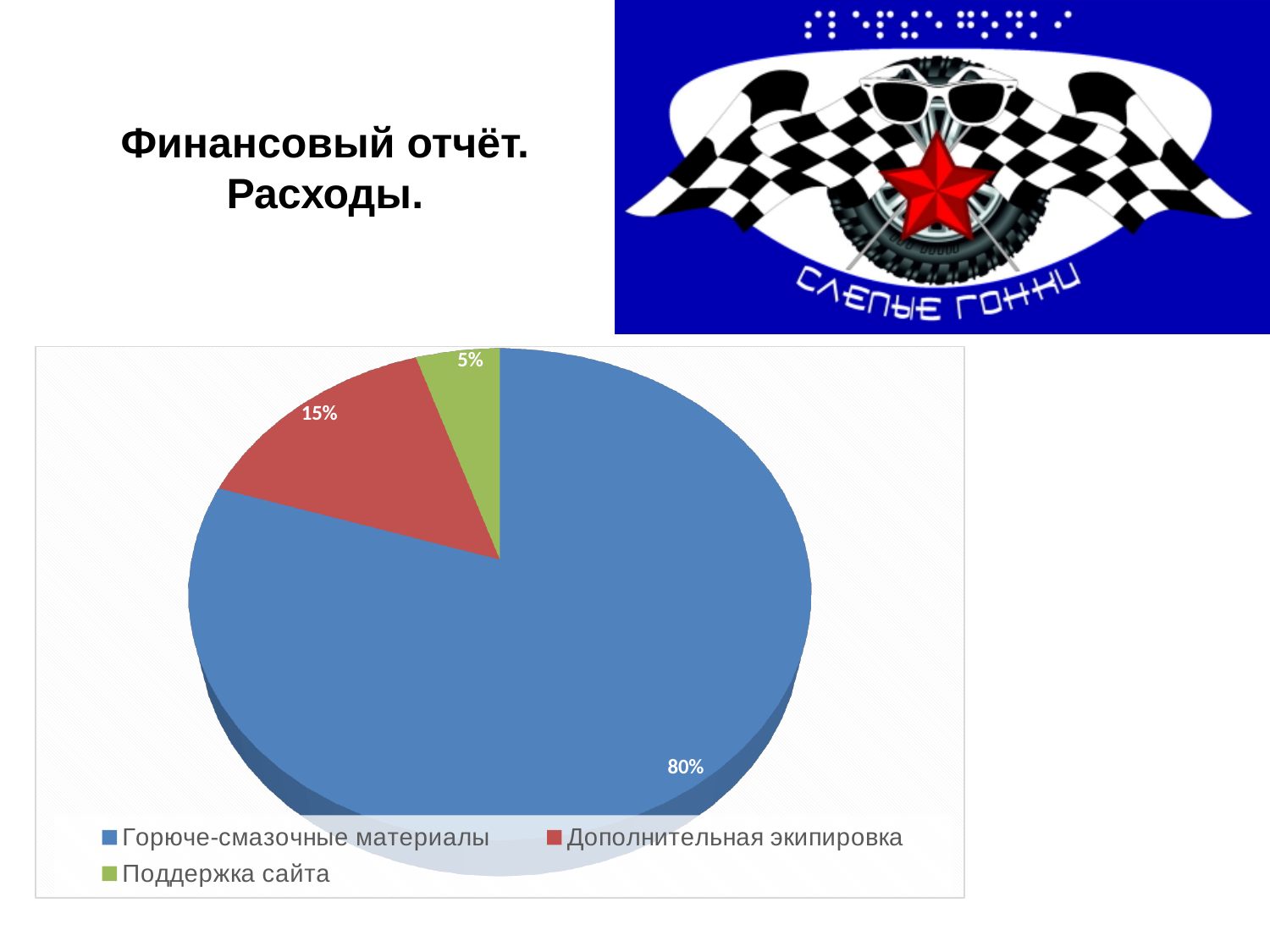
What colour is the slice for Поддержка сайта? Green What share of expenses is Поддержка сайта? 5% What is the difference in percentage points between Горюче-смазочные материалы and Дополнительная экипировка? 65 What kind of chart is shown on the slide? Pie chart What is the difference in percentage points between Дополнительная экипировка and Поддержка сайта? 10 What is the title of the slide containing the chart? Финансовый отчёт. Расходы. Which category has the largest share of the pie? Горюче-смазочные материалы How many categories does the pie chart show? 3 What share of expenses is Дополнительная экипировка? 15% Which category has the smallest share of the pie? Поддержка сайта What share of expenses is Горюче-смазочные материалы? 80% Which is larger: the share for Дополнительная экипировка or for Поддержка сайта? Дополнительная экипировка